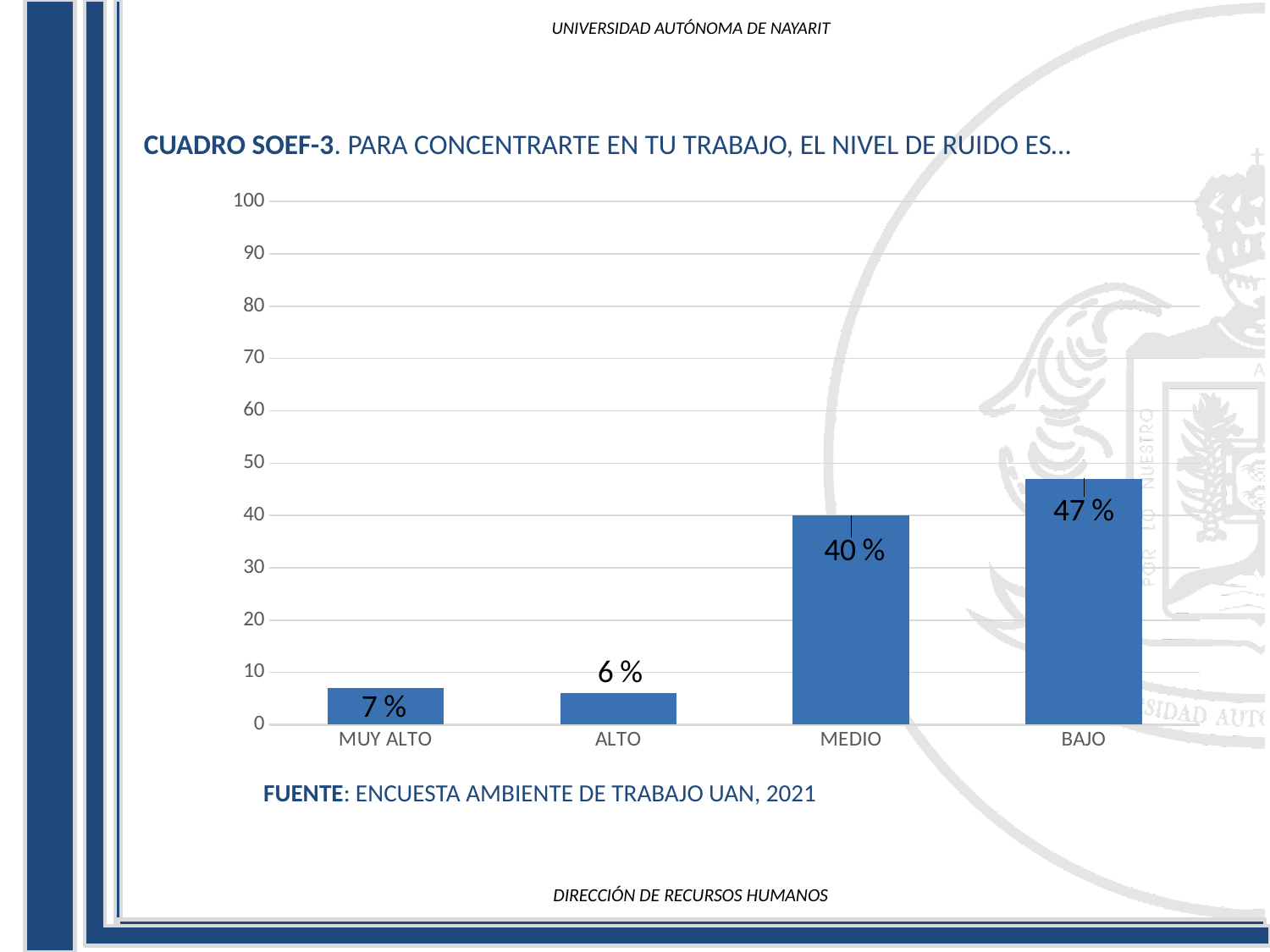
Which category has the lowest value? ALTO Which is larger, the value for MEDIO or the value for MUY ALTO? MEDIO What is the value for BAJO? 47 % What is the value for MUY ALTO? 7 % What is the source cited below the chart? ENCUESTA AMBIENTE DE TRABAJO UAN, 2021 What is the difference between the values for BAJO and MEDIO? 7 % How many categories are shown on the x axis? 4 What is the value for MEDIO? 40 % Which category has the highest value? BAJO What kind of chart is shown on the slide? bar chart Is the value for BAJO greater or less than 50? less What is the value for ALTO? 6 %